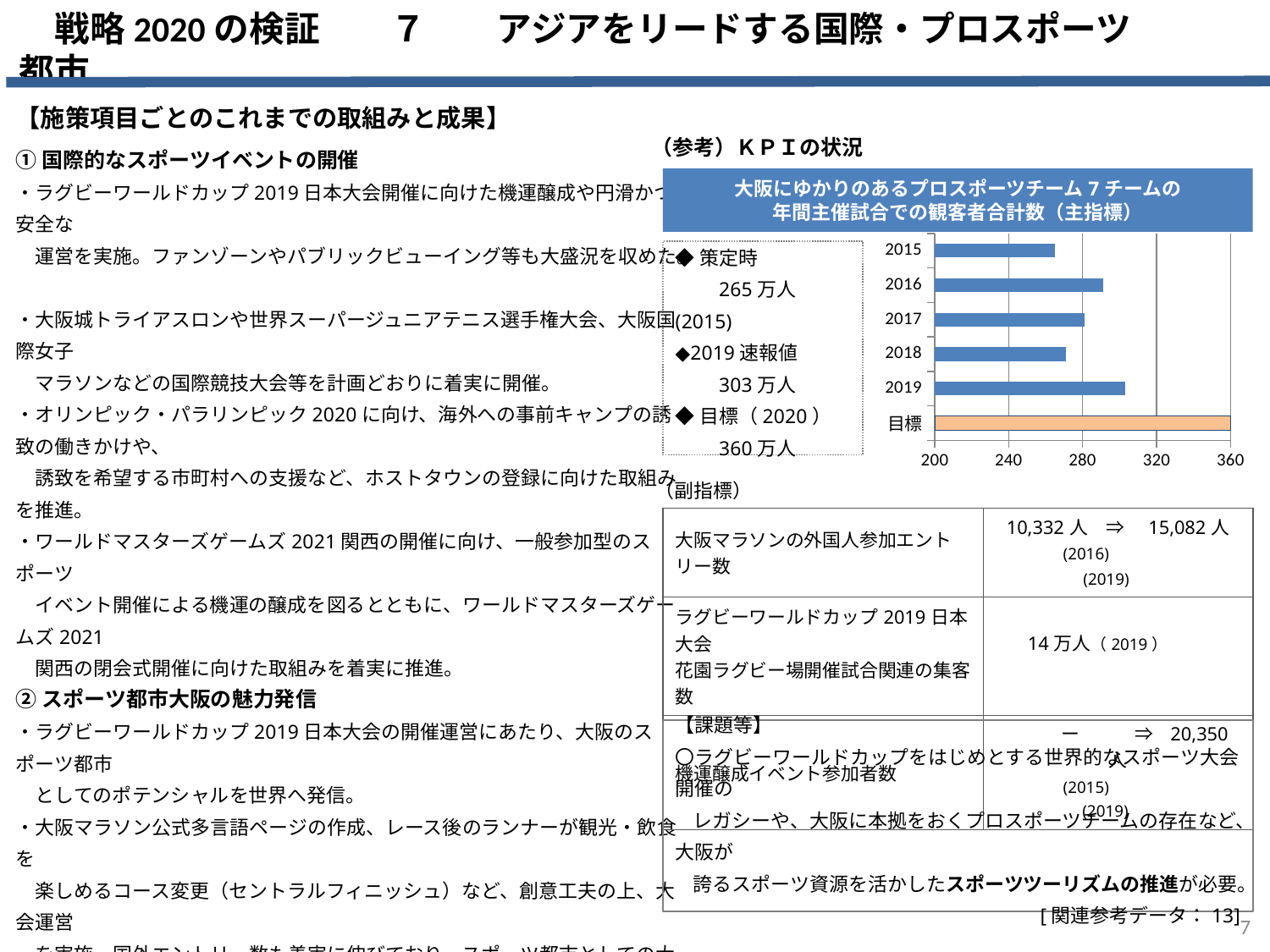
Among the years 2015 to 2019 in the KPI chart, which year has the longest bar? 2019 In the KPI chart, is the value for 2019 greater or less than 320? less In the KPI chart, is the value for 2015 greater or less than 280? less In the KPI chart, is the value for 2016 greater or less than 280? greater How many bars does the KPI chart show? 6 What value does the 目標 bar reach on the axis of the KPI chart? 360 What colour is the 目標 bar in the KPI chart, compared with the other bars? orange (the others are blue) Which category has the longest bar in the KPI chart? 目標 In the KPI chart, which bar is longer, 2016 or 2018? 2016 According to the text beside the KPI chart, what is the 2019 速報値? 303 万人 What kind of chart is shown under the KPI heading on the slide? bar chart